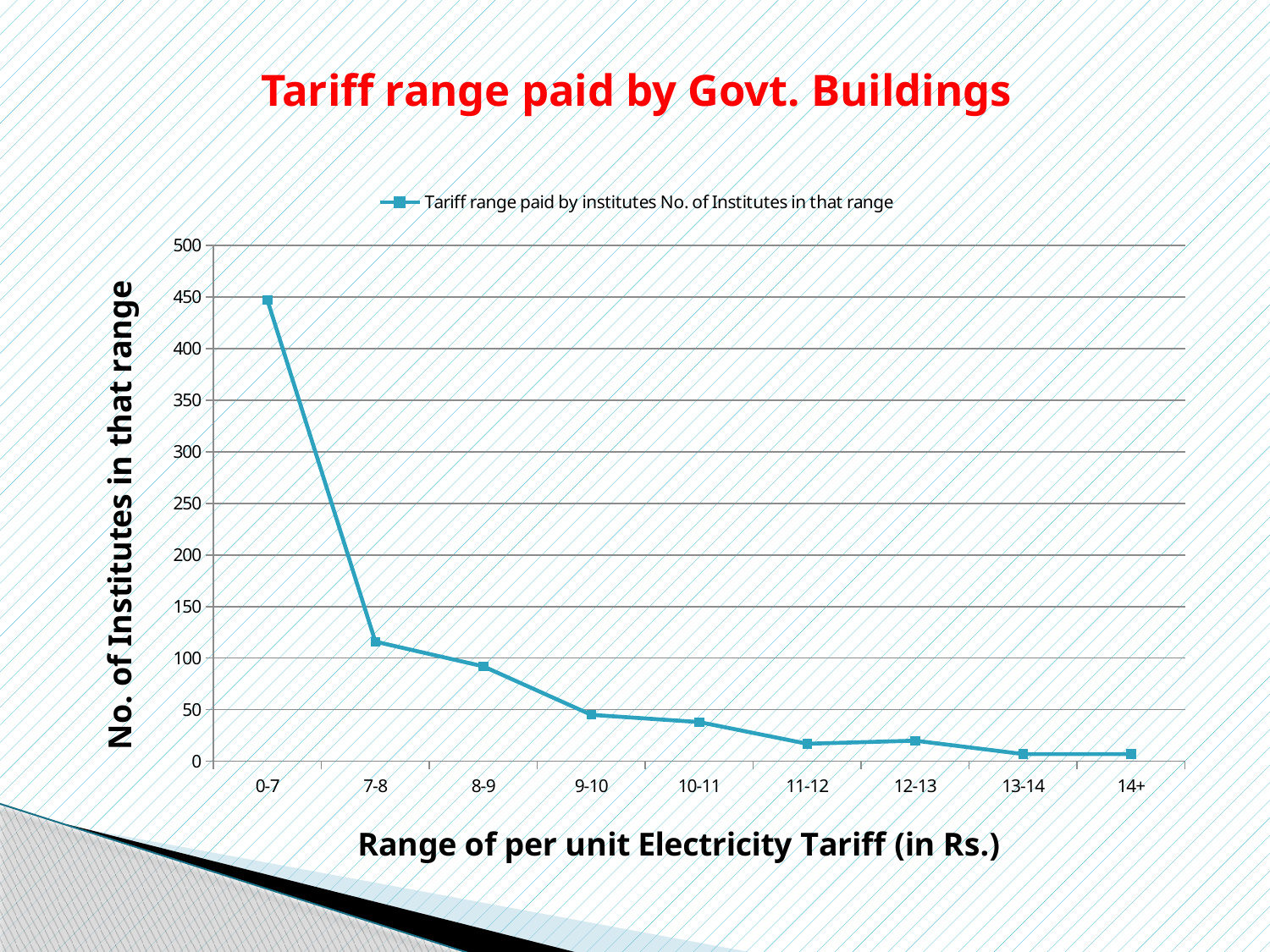
Do the values rise or fall as the tariff range increases along the x axis? fall Is the value for the 0-7 tariff range greater or less than 400? greater Is the value for the 7-8 tariff range greater or less than 100? greater What is the title of the chart on the slide? Tariff range paid by Govt. Buildings Which tariff range has the highest number of institutes? 0-7 How many tariff range categories are plotted on the x axis? 9 Which has more institutes, the 7-8 range or the 8-9 range? 7-8 What kind of chart is shown on the slide? line chart How many series does the legend list? 1 Which has more institutes, the 9-10 range or the 11-12 range? 9-10